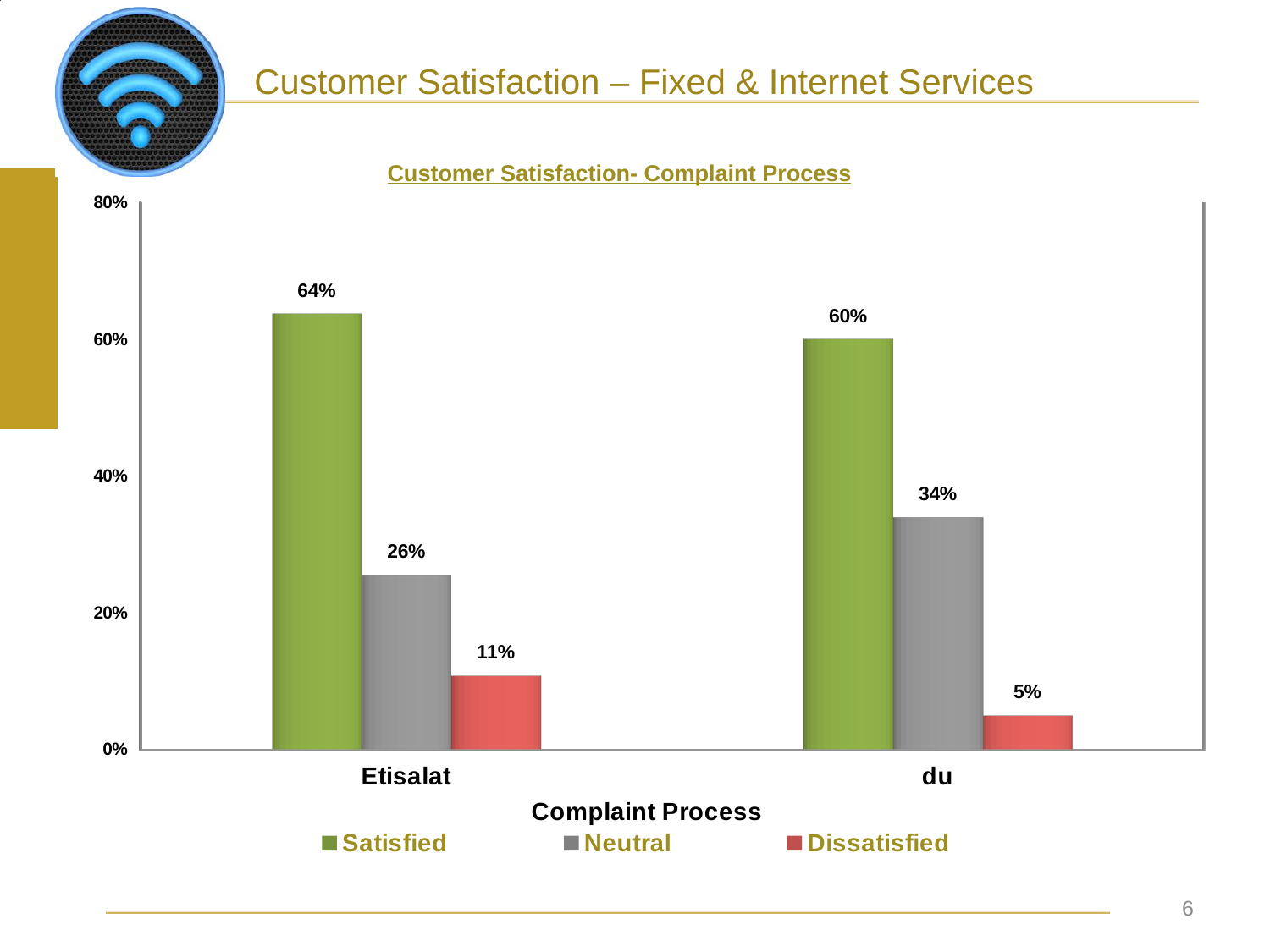
What is the Dissatisfied value for Etisalat? 11% How many providers are shown on the x axis? 2 Which provider has the lower Dissatisfied value? du What is the difference between the Neutral values for du and Etisalat? 8% What is the Satisfied value for Etisalat? 64% Which provider has the higher Satisfied value? Etisalat What is the Neutral value for du? 34% How many series does the legend list? 3 What is the Dissatisfied value for du? 5% Is the Neutral value for Etisalat larger or smaller than the Neutral value for du? smaller Is the Satisfied value for du greater or less than 40%? greater What kind of chart is shown on the slide? bar chart